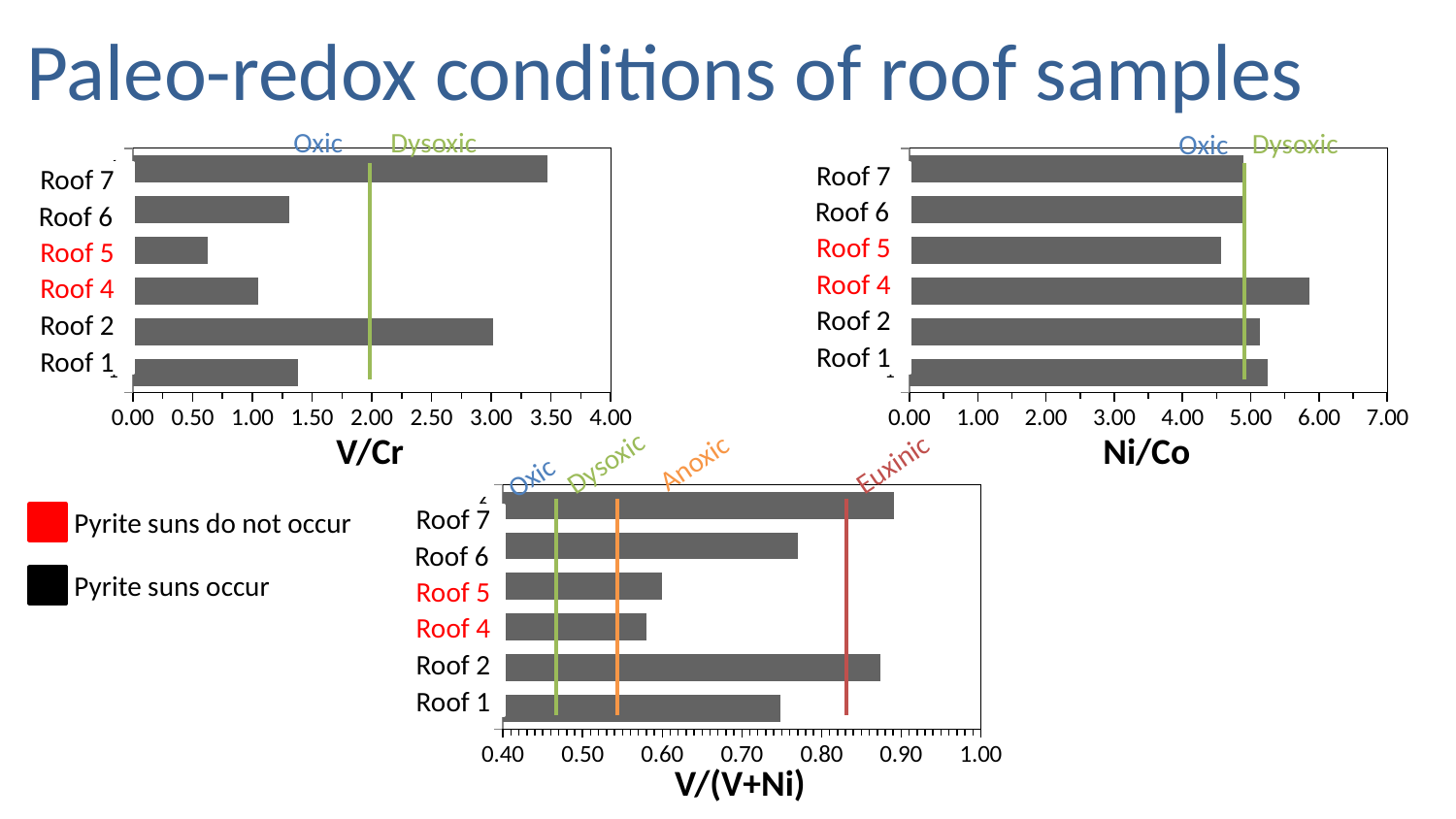
In the V/Cr chart, which roof sample has the highest V/Cr value? Roof 7 In the Ni/Co chart, which roof sample has the lowest Ni/Co value? Roof 5 How many roof samples are plotted in the V/Cr chart? 6 In the V/(V+Ni) chart, which is larger, the value for Roof 7 or the value for Roof 4? Roof 7 In the V/Cr chart, is the value for Roof 5 greater or less than 1.00? less In the V/Cr chart, which roof sample has the lowest V/Cr value? Roof 5 In the V/(V+Ni) chart, is the value for Roof 6 greater or less than 0.70? greater What kind of chart is the Ni/Co chart? bar chart In the Ni/Co chart, which roof sample has the highest Ni/Co value? Roof 4 In the Ni/Co chart, is the value for Roof 4 greater or less than 5.00? greater According to the legend, what does a red roof label indicate? Pyrite suns do not occur